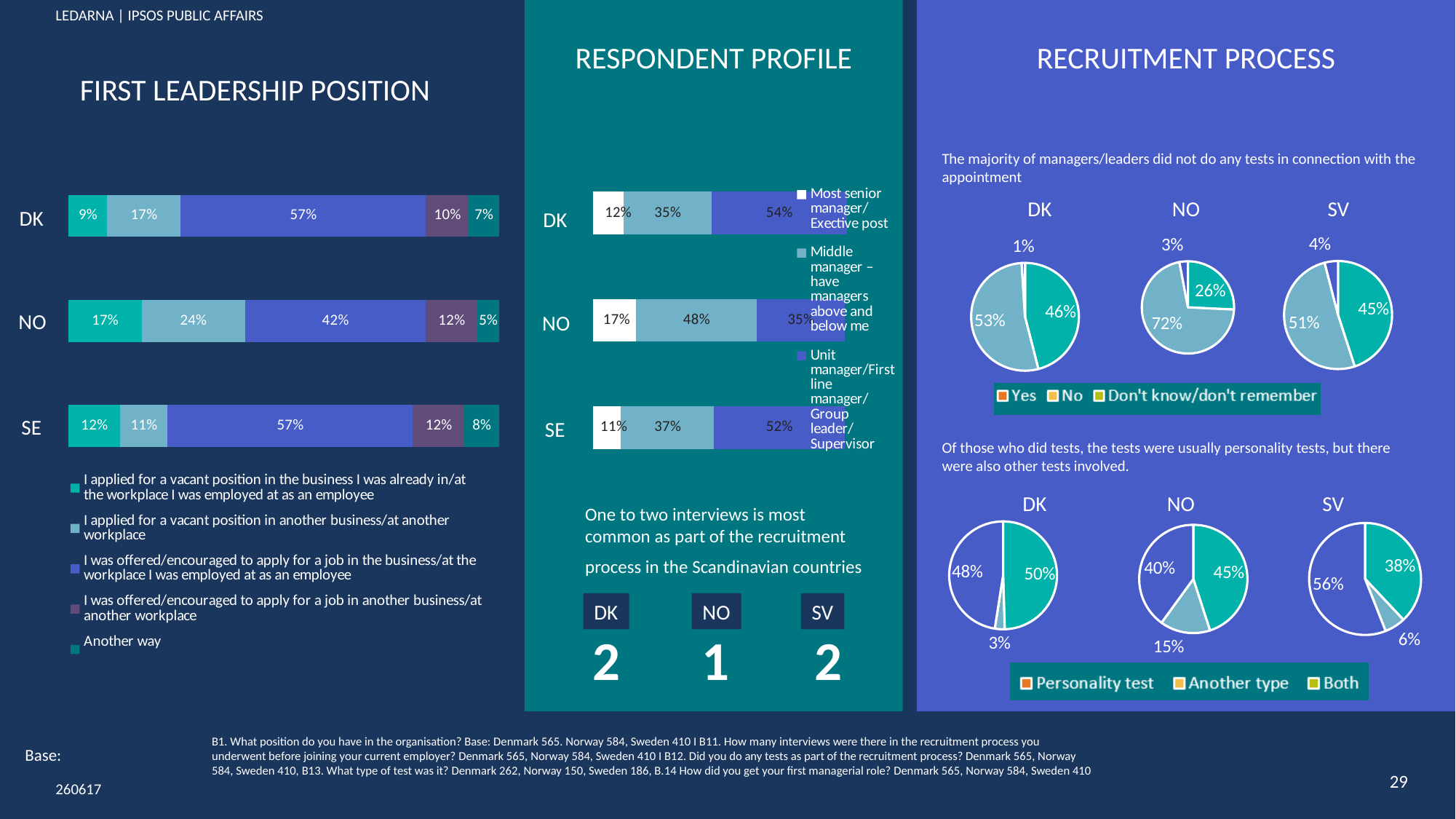
In the Respondent Profile chart, what percentage of NO respondents are middle managers? 48% In the Recruitment Process top row of pie charts (tests in connection with the appointment), what share of NO respondents answered 'No'? 72% In the First Leadership Position chart, what percentage of SE respondents were offered/encouraged to apply for a job in the business/at the workplace they were already employed at? 57% How many categories does the legend of the First Leadership Position chart list? 5 In the Respondent Profile chart, which country has the highest share of Unit manager/First line manager/Group leader/Supervisor? DK In the First Leadership Position chart, what is the difference between DK and NO for 'I was offered/encouraged to apply for a job in the business/at the workplace I was employed at as an employee'? 15 percentage points In the First Leadership Position chart, which country has the highest share for 'I applied for a vacant position in another business/at another workplace'? NO In the Respondent Profile chart, which has the larger share of middle managers, NO or SE? NO In the Recruitment Process bottom row of pie charts (type of test), what share of NO respondents answered 'Both'? 40% What type of chart is the Respondent Profile chart? Stacked bar chart In the Recruitment Process bottom row of pie charts (type of test), what share of SV respondents answered 'Another type'? 6% In the Recruitment Process top row of pie charts (tests in connection with the appointment), which country has the lowest 'Yes' share? NO